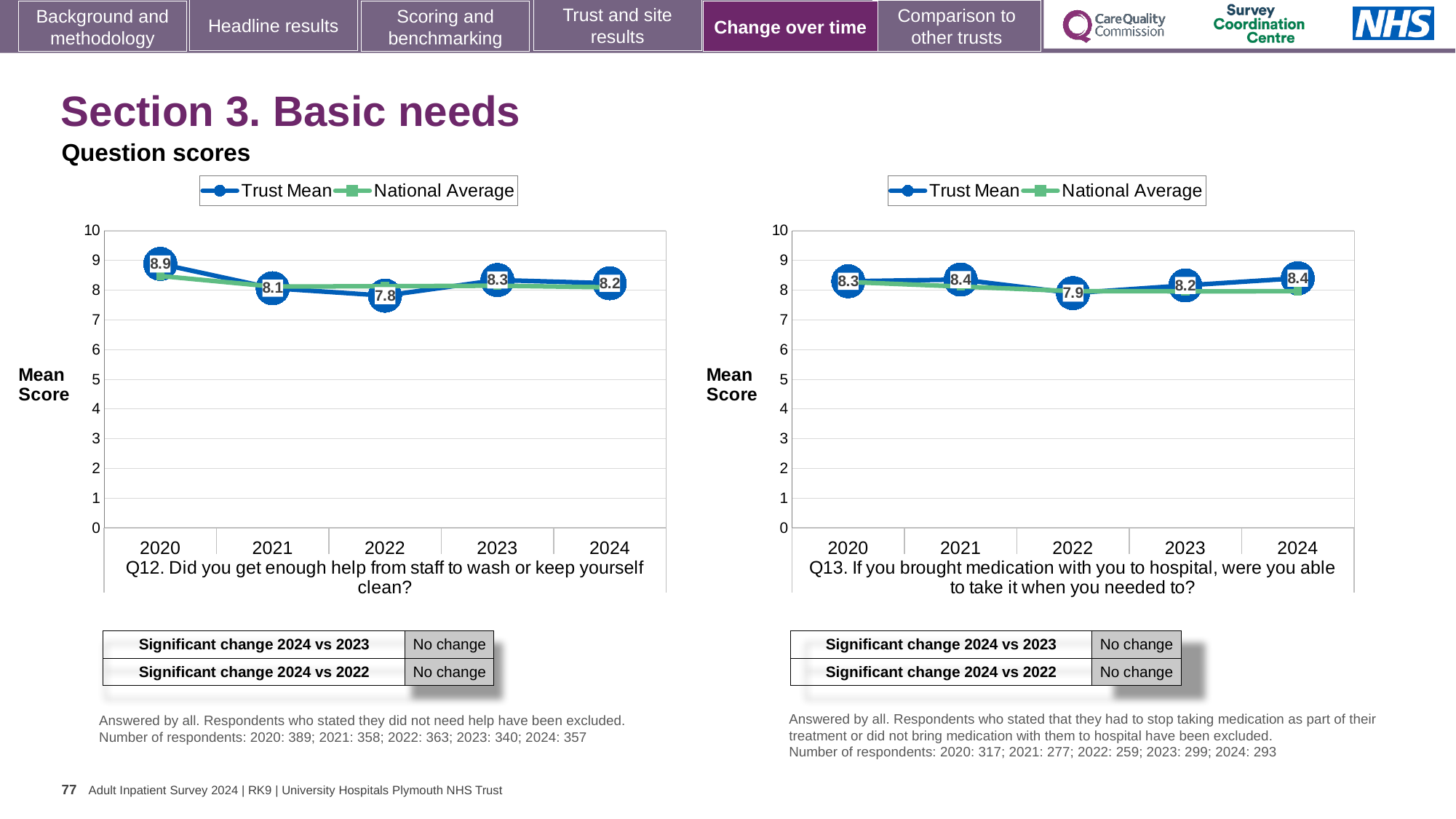
In the Q12 chart (left), what is the Trust Mean for 2022? 7.8 In the Q12 chart (left), which year has the highest Trust Mean? 2020 In the Q12 chart (left), is the National Average for 2020 greater or less than 9? less In the Q13 chart (right), what is the difference between the Trust Mean for 2024 and 2022? 0.5 In the Q12 chart (left), what is the Trust Mean for 2020? 8.9 In the Q13 chart (right), what is the Trust Mean for 2024? 8.4 In the Q13 chart (right), is the Trust Mean higher in 2021 or in 2023? 2021 In the Q12 chart (left), what is the difference between the Trust Mean for 2020 and 2022? 1.1 What type of chart is used for Q12 (left)? Line chart How many series does the legend of the Q13 chart (right) list? 2 How many years are shown on the x axis of the Q12 chart (left)? 5 In the Q13 chart (right), which year has the lowest Trust Mean? 2022